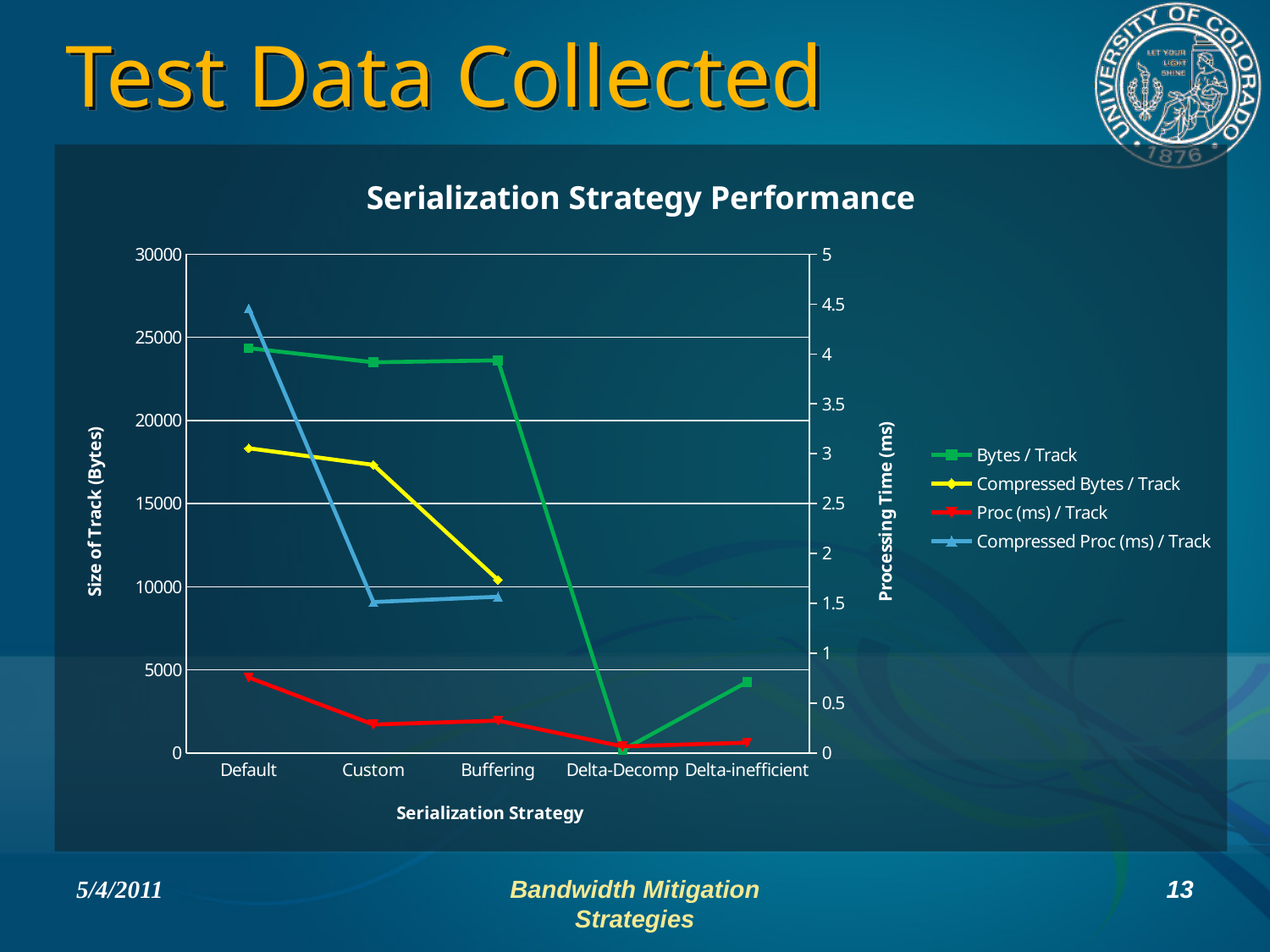
How many serialization strategies are shown on the x axis? 5 Is the Compressed Bytes / Track value for Default greater or less than 20000? less What is the label of the right-hand vertical axis? Processing Time (ms) Does the Compressed Bytes / Track series rise or fall from Default to Buffering? fall Which serialization strategy has the lowest Bytes / Track value? Delta-Decomp What is the title of the chart? Serialization Strategy Performance What type of chart is shown on the slide? Line chart How many series does the legend list? 4 Is the Compressed Proc (ms) / Track value for Default greater or less than 4? greater Is the Proc (ms) / Track value for Default greater or less than 1? less Which serialization strategy has the highest Compressed Proc (ms) / Track value? Default